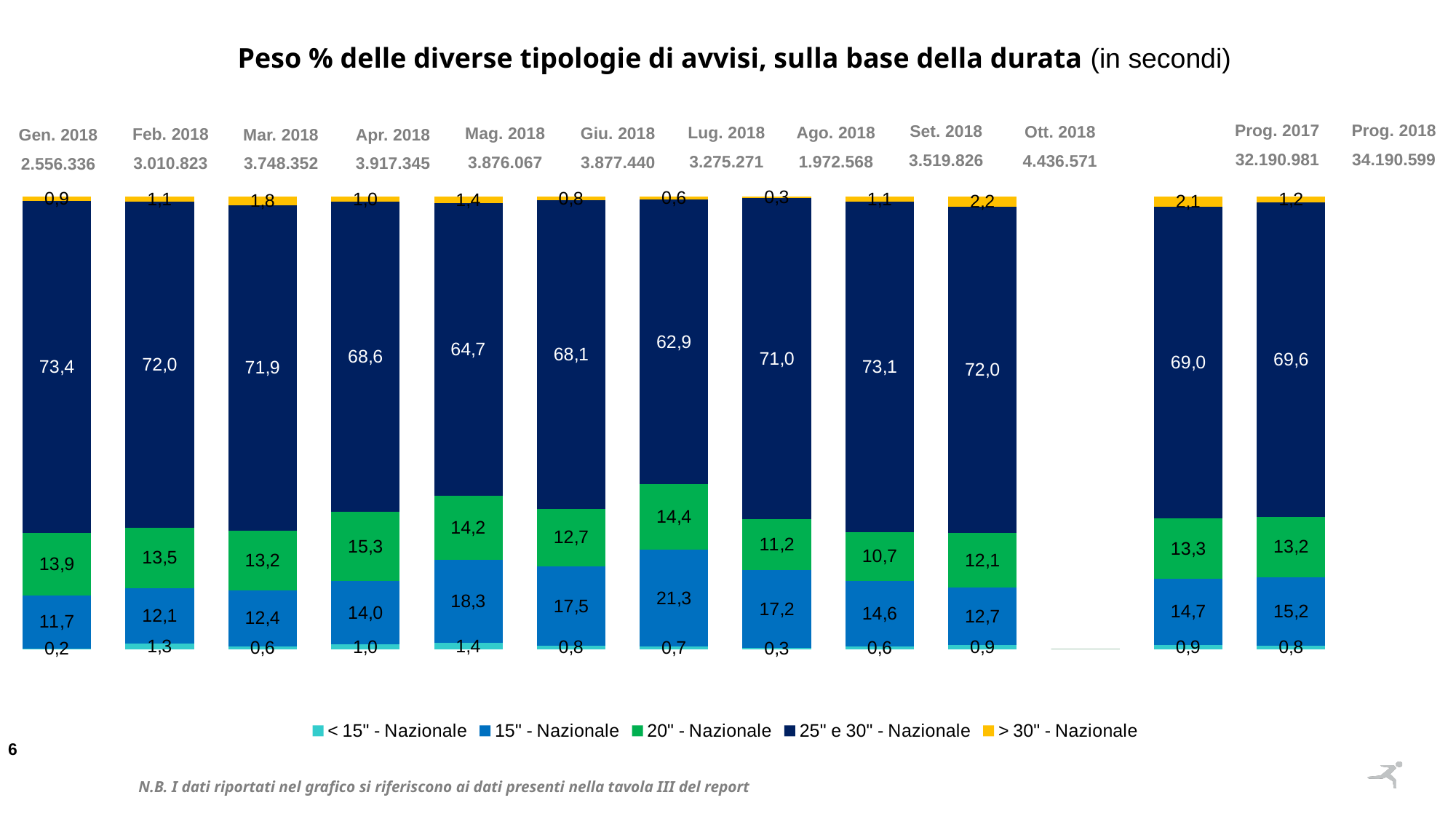
What is the value of the < 15" - Nazionale series for Feb. 2018? 1,3 How many series does the legend list? 5 For Gen. 2018, which is larger: the 15" - Nazionale value or the 20" - Nazionale value? 20" - Nazionale What kind of chart is shown on the slide? Stacked bar chart What is the value of the 25" e 30" - Nazionale series for Gen. 2018? 73,4 What is the value of the 20" - Nazionale series for Apr. 2018? 15,3 Which category has the highest value for the 25" e 30" - Nazionale series? Gen. 2018 Which legend entry is shown in yellow? > 30" - Nazionale